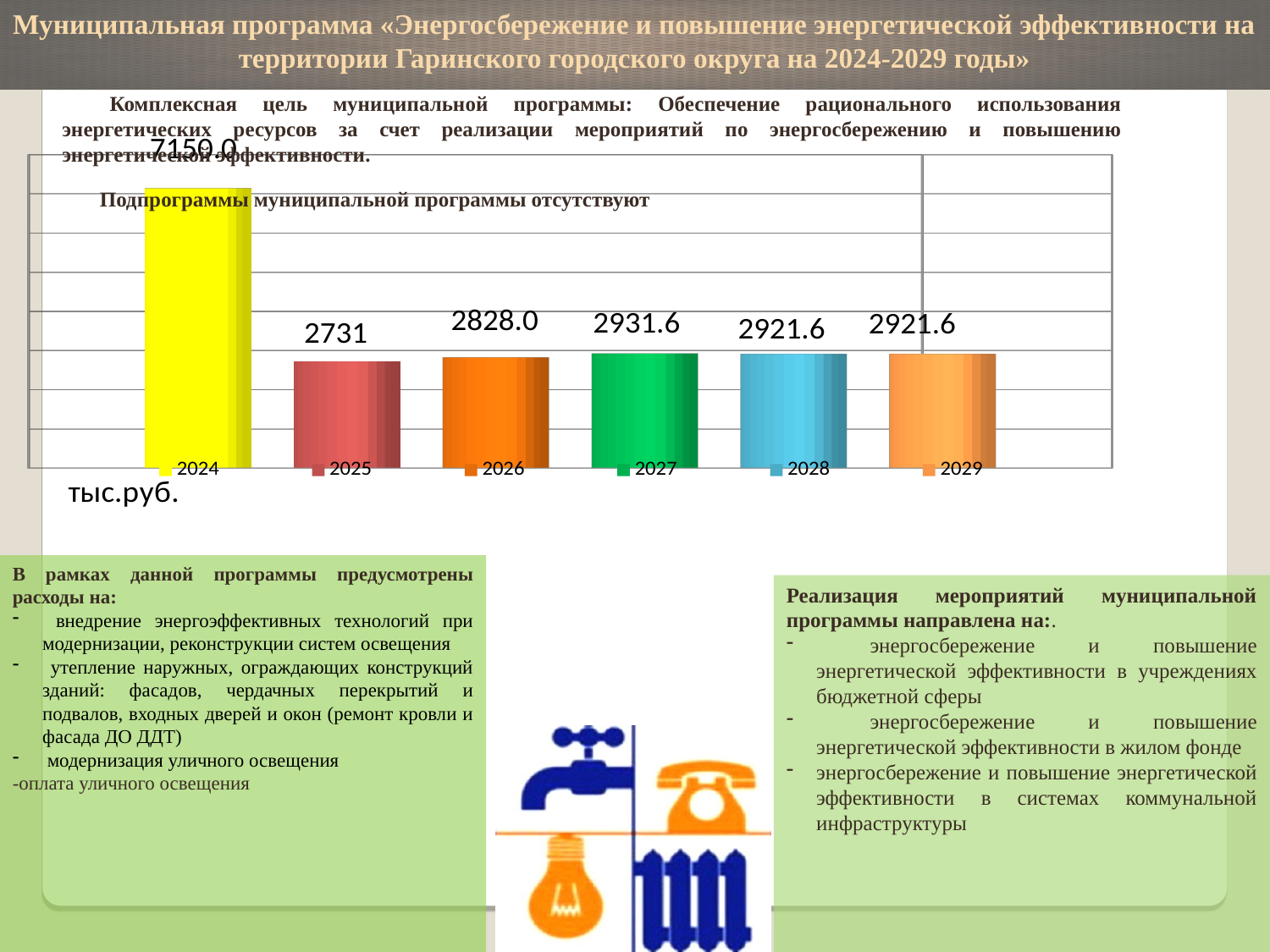
How many years are shown in the bar chart? 6 What is the value for 2025 in the bar chart? 2731 What is the difference between the values for 2026 and 2025? 97.0 What is the value for 2029 in the bar chart? 2921.6 What type of chart is shown on the slide? bar chart Which year has the highest value in the bar chart? 2024 What is the value for 2028 in the bar chart? 2921.6 Which is larger, the value for 2026 or the value for 2025? 2026 What is the value for 2026 in the bar chart? 2828.0 Which year has the lowest value in the bar chart? 2025 What is the difference between the values for 2027 and 2026? 103.6 What is the value for 2027 in the bar chart? 2931.6